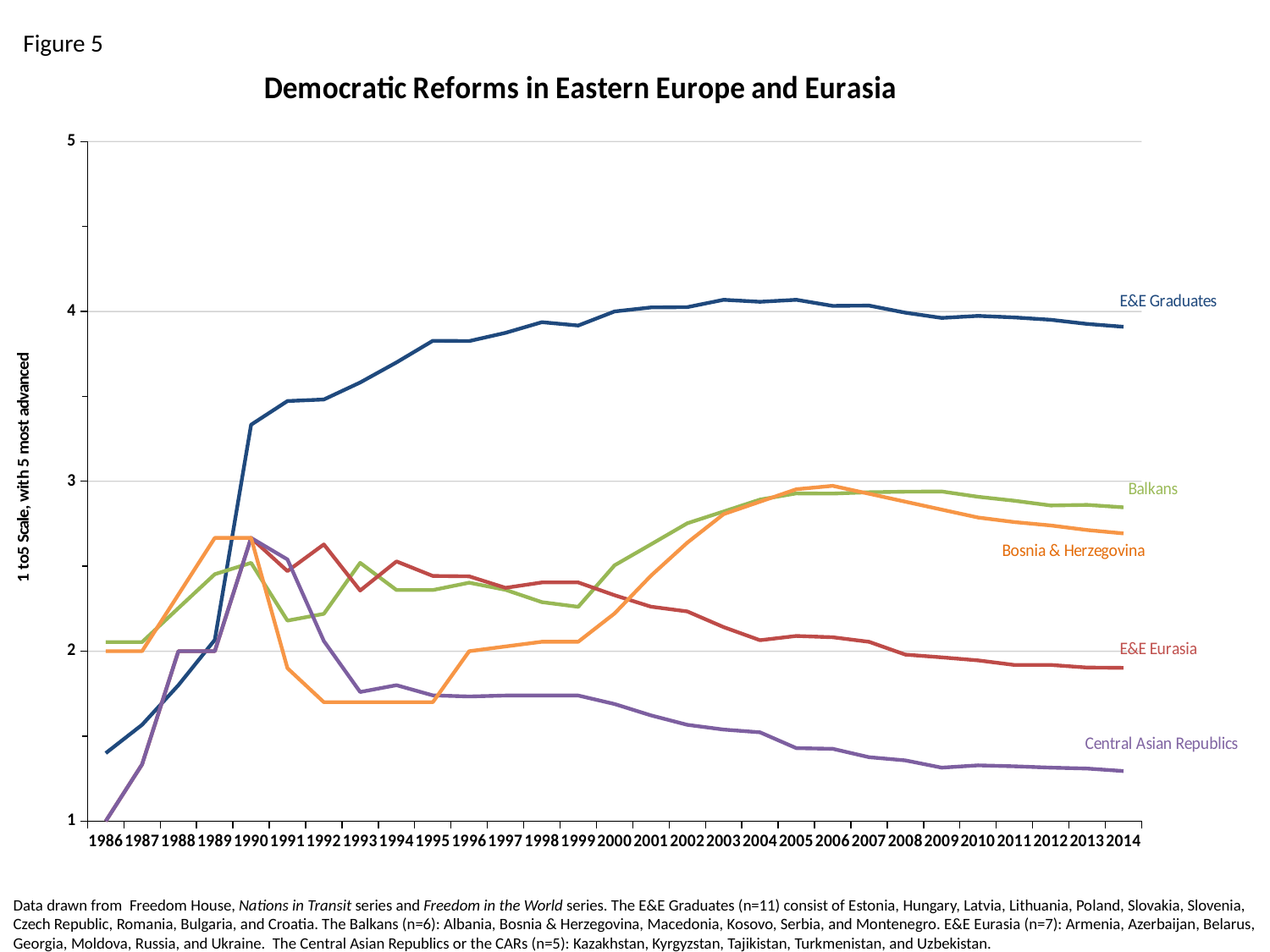
Does the E&E Graduates line rise or fall from 1986 to 2014? rise Is the value for E&E Graduates in 1986 greater or less than 2? less How many years are shown along the x axis? 29 Is the value for Central Asian Republics in 2014 greater or less than 2? less How many series are plotted on the chart? 5 Does the Central Asian Republics line rise or fall from 2000 to 2014? fall Which series has the lowest value in 2014? Central Asian Republics What is the title of the chart? Democratic Reforms in Eastern Europe and Eurasia What kind of chart is shown on the slide? line chart In 2014, which is larger: the value for Balkans or the value for E&E Eurasia? Balkans Is the value for E&E Graduates in 2014 greater or less than 3? greater Which series has the highest value in 2014? E&E Graduates